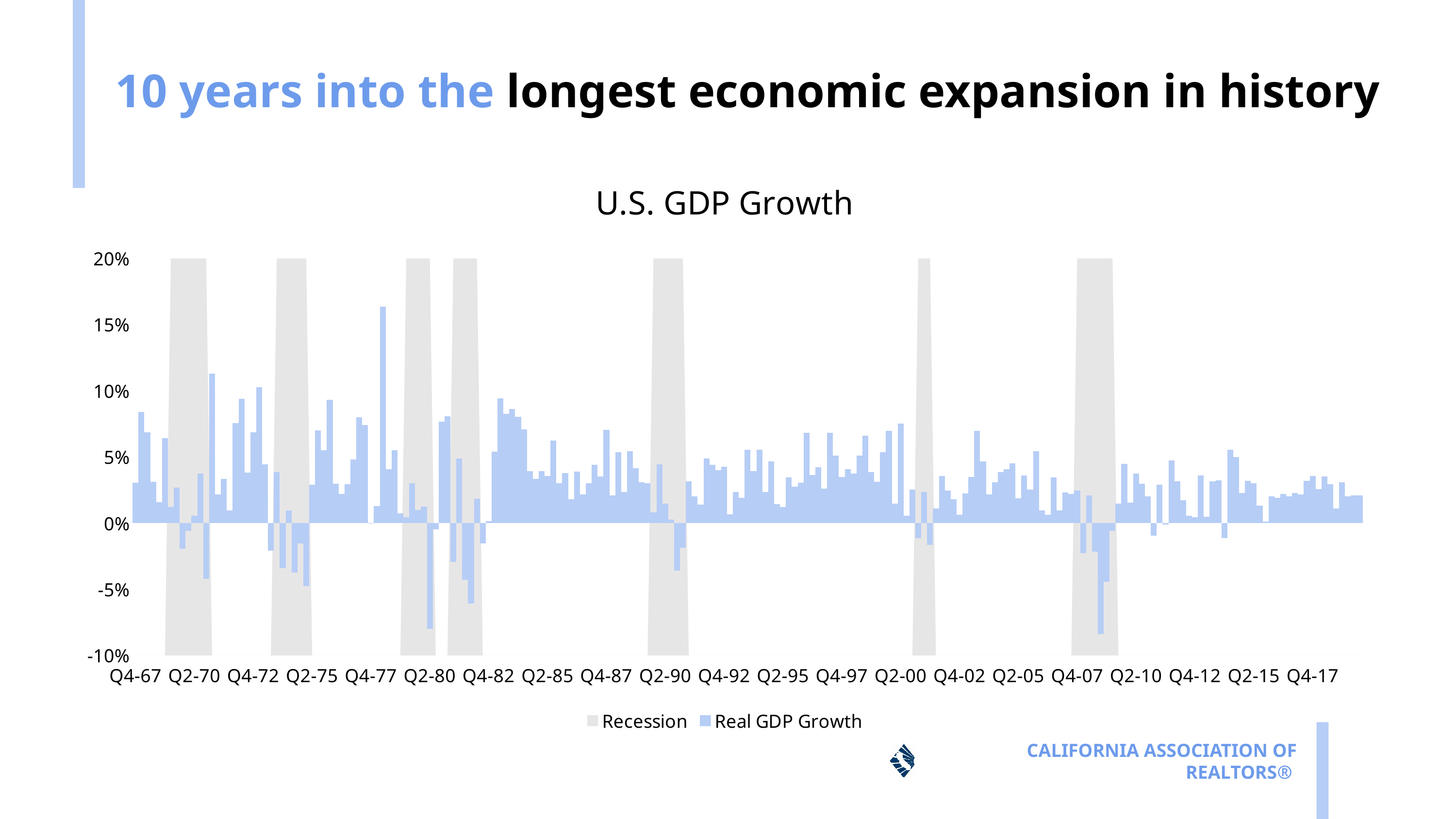
How many shaded recession periods are marked on the chart? 7 What kind of chart is shown on the slide? Bar chart What is the title of the chart? U.S. GDP Growth Is the lowest Real GDP Growth bar on the chart greater or less than -5%? less What is the highest value shown on the vertical axis? 20% What is the last quarter label shown on the horizontal axis? Q4-17 Is the Real GDP Growth value at Q4-17 greater or less than 5%? less Is the tallest Real GDP Growth bar on the chart greater or less than 15%? greater What is the lowest value shown on the vertical axis? -10% What are the two legend entries of the chart? Recession and Real GDP Growth What is the first quarter label shown on the horizontal axis? Q4-67 How many entries does the chart's legend list? 2